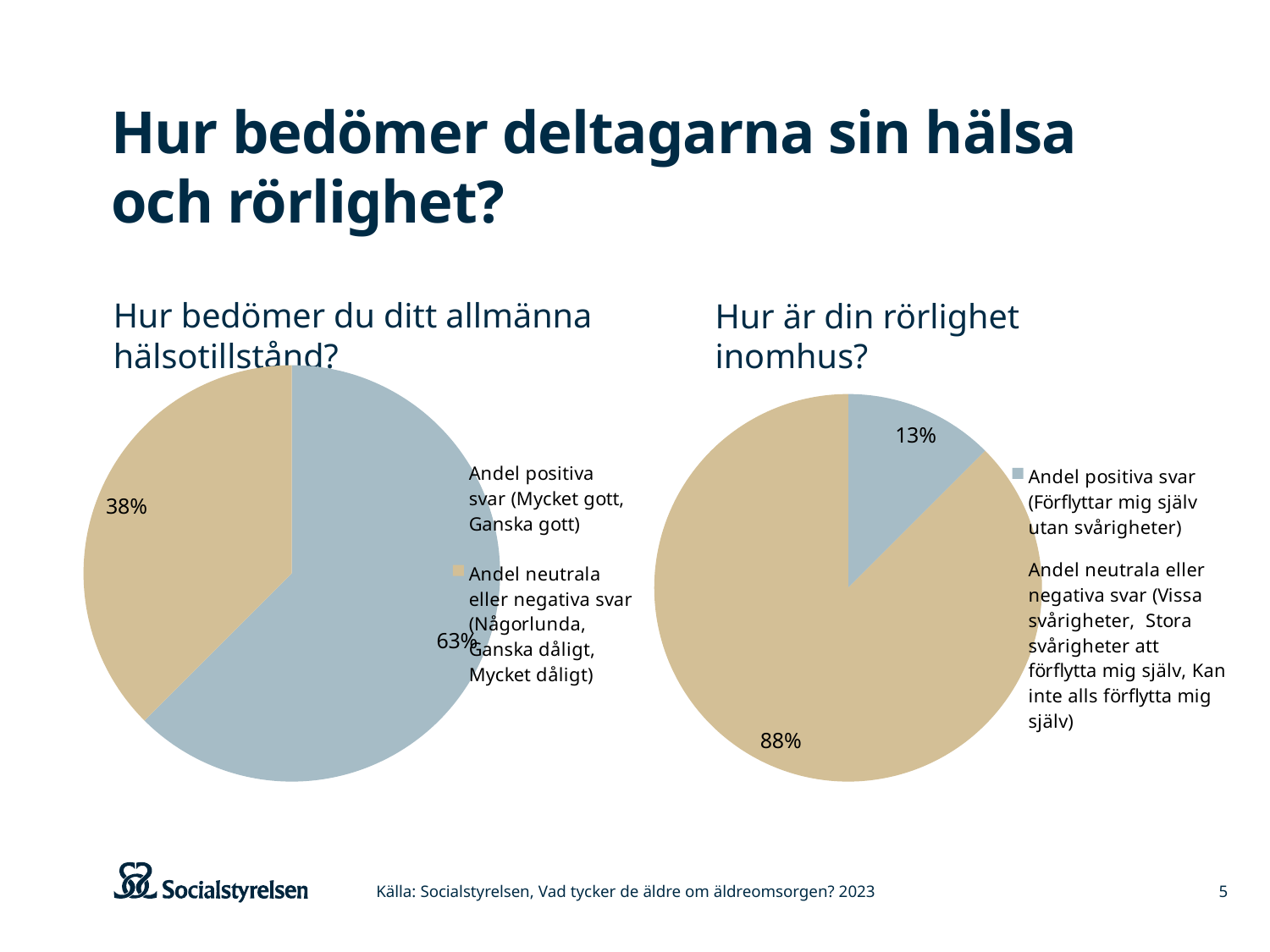
In the left pie chart ('Hur bedömer du ditt allmänna hälsotillstånd?'), how many percentage points larger is the positive share than the neutral/negative share? 25 percentage points In the right pie chart ('Hur är din rörlighet inomhus?'), which slice is the smallest? Andel positiva svar (Förflyttar mig själv utan svårigheter) In the right pie chart ('Hur är din rörlighet inomhus?'), what share is labelled for 'Andel positiva svar (Förflyttar mig själv utan svårigheter)'? 13% In the right pie chart ('Hur är din rörlighet inomhus?'), how many percentage points larger is the neutral/negative share than the positive share? 75 percentage points What kind of chart is used on the left of the slide, under 'Hur bedömer du ditt allmänna hälsotillstånd?'? Pie chart In the right pie chart ('Hur är din rörlighet inomhus?'), what share is labelled for 'Andel neutrala eller negativa svar'? 88% In the left pie chart ('Hur bedömer du ditt allmänna hälsotillstånd?'), what share is labelled for 'Andel positiva svar (Mycket gott, Ganska gott)'? 63% In the left pie chart ('Hur bedömer du ditt allmänna hälsotillstånd?'), what share is labelled for 'Andel neutrala eller negativa svar'? 38% Which chart shows a larger share of positive answers: the left one ('Hur bedömer du ditt allmänna hälsotillstånd?') or the right one ('Hur är din rörlighet inomhus?')? The left one (Hur bedömer du ditt allmänna hälsotillstånd?) In the left pie chart ('Hur bedömer du ditt allmänna hälsotillstånd?'), which colour represents 'Andel positiva svar'? Blue-grey In the left pie chart ('Hur bedömer du ditt allmänna hälsotillstånd?'), which slice is the largest? Andel positiva svar (Mycket gott, Ganska gott) How many slices does the right pie chart ('Hur är din rörlighet inomhus?') have? 2